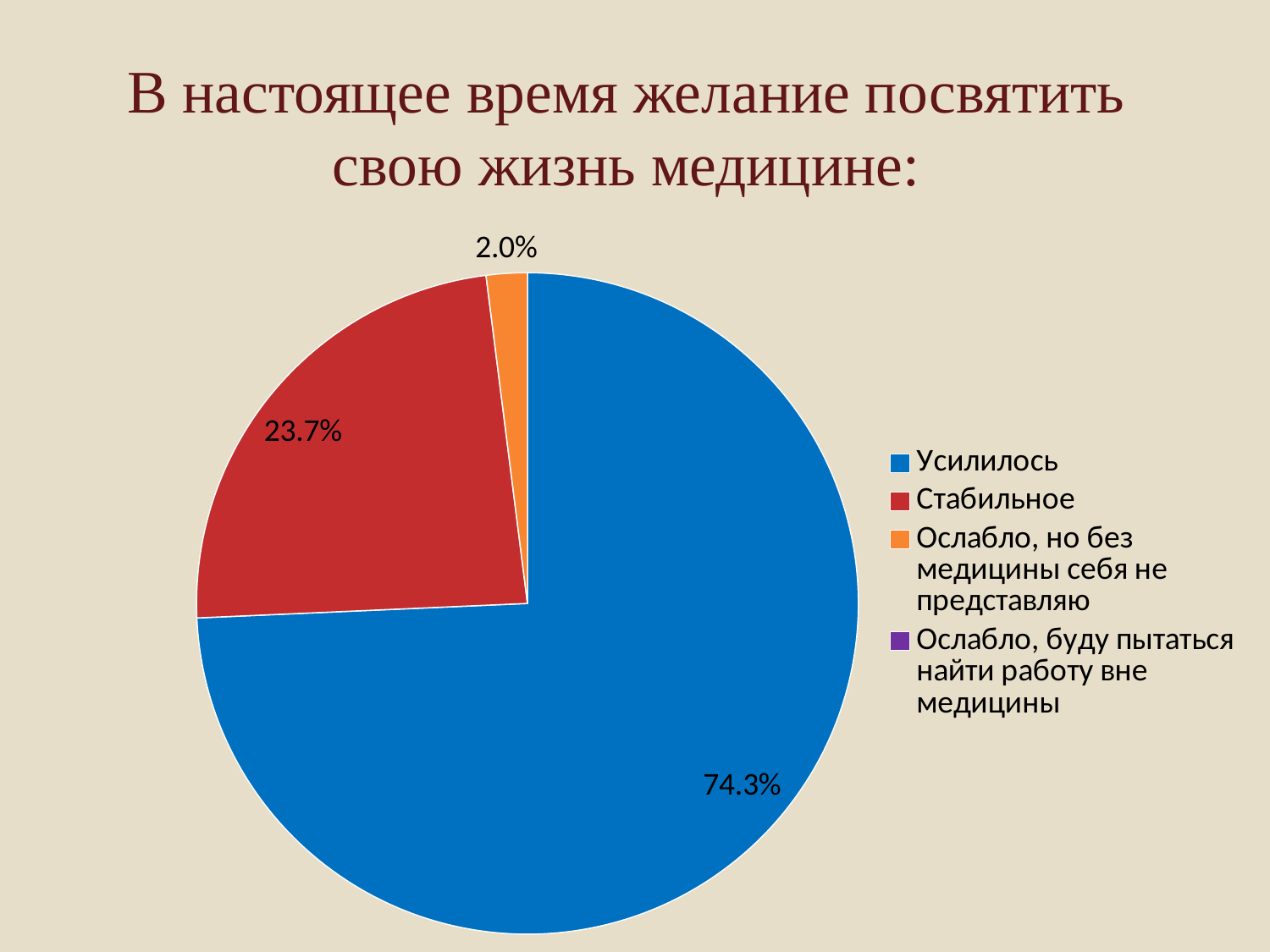
Which labelled slice is the smallest? Ослабло, но без медицины себя не представляю How many entries does the legend list? 4 What is the value shown for "Стабильное"? 23.7% What kind of chart is shown on the slide? Pie chart What colour is the slice for "Усилилось"? Blue Which category has the largest slice of the pie? Усилилось Which is larger, the share for "Стабильное" or the share for "Ослабло, но без медицины себя не представляю"? Стабильное What is the difference between the "Стабильное" and "Ослабло, но без медицины себя не представляю" shares? 21.7% What is the value shown for "Ослабло, но без медицины себя не представляю"? 2.0% What share of the pie does "Усилилось" take? 74.3% What is the difference between the "Усилилось" and "Стабильное" shares? 50.6% How many slices with data labels are visible in the pie? 3